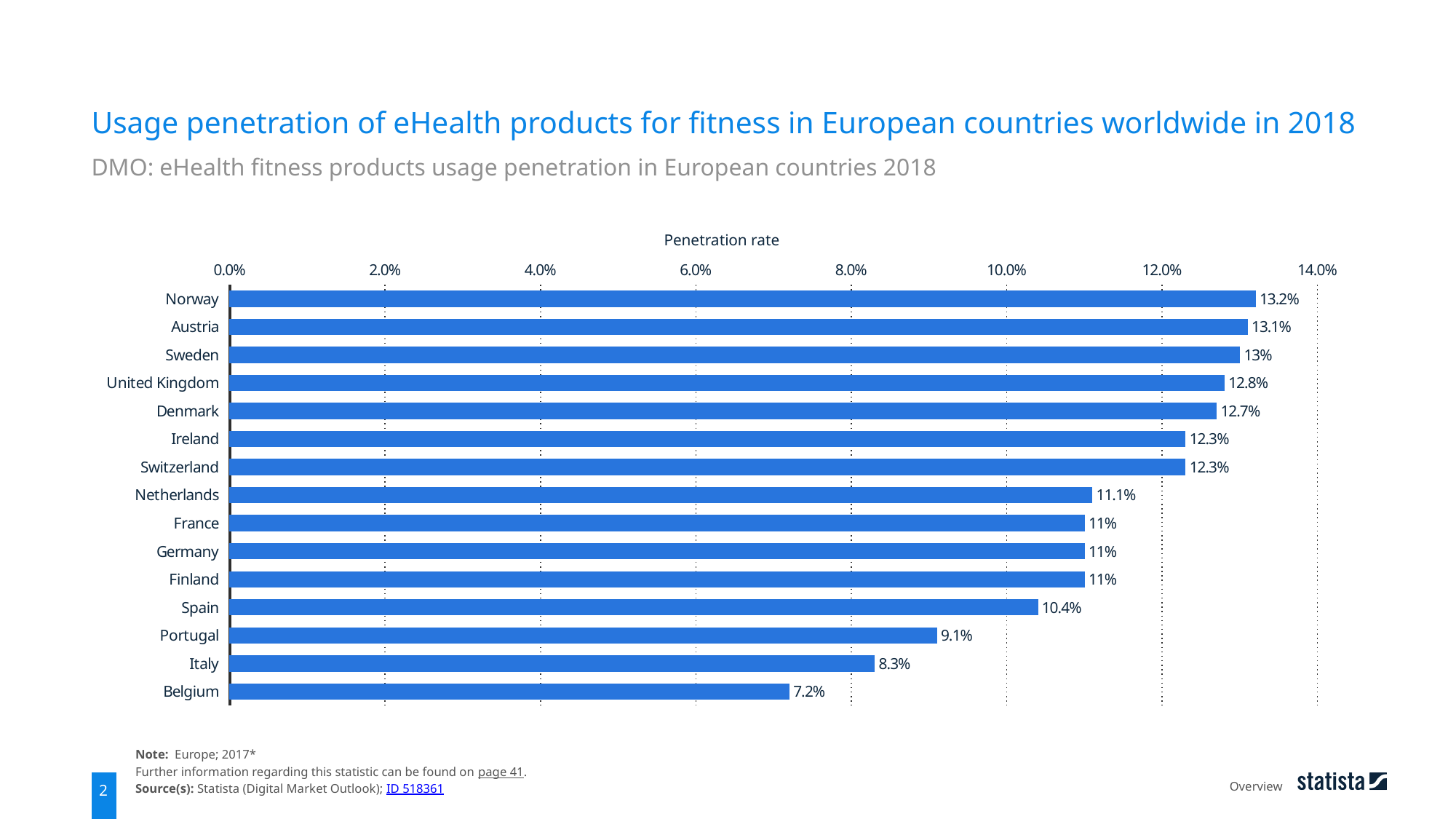
What is the difference between the penetration rates of Portugal and Italy? 0.8% What is the difference between the penetration rates of Norway and Belgium? 6% What kind of chart is shown on the slide? Bar chart Which country has the highest penetration rate? Norway What is the label of the horizontal axis? Penetration rate Which country has the lowest penetration rate? Belgium What is the penetration rate for Belgium? 7.2% Is the penetration rate for Italy greater or less than 10.0%? less How many countries are shown in the chart? 15 Which has a higher penetration rate, Spain or Portugal? Spain What is the penetration rate for Spain? 10.4% What is the penetration rate for Norway? 13.2%